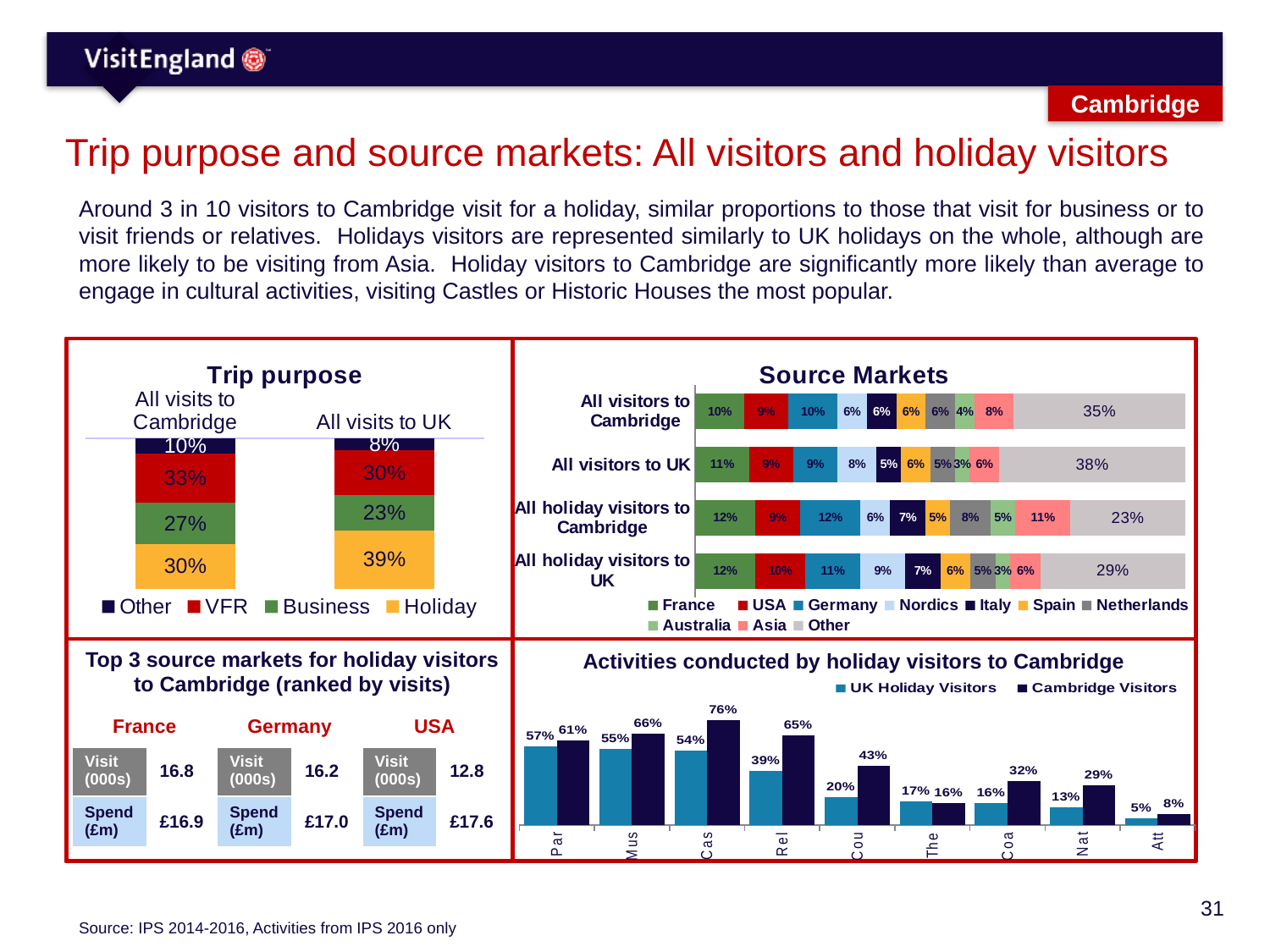
In the Activities conducted by holiday visitors to Cambridge chart, what is the difference between Cambridge Visitors and UK Holiday Visitors for the category labelled Rel? 26 percentage points In the Trip purpose chart, what percentage of all visits to UK are VFR? 30% In the Activities conducted by holiday visitors to Cambridge chart, what is the value for Cambridge Visitors for the category labelled Cas? 76% In the Source Markets chart, what is the Other share for all visitors to UK? 38% In the Activities conducted by holiday visitors to Cambridge chart, which category has the highest value for Cambridge Visitors? Cas In the Trip purpose chart, what percentage of all visits to Cambridge are for Holiday? 30% How many series does the legend of the Source Markets chart list? 10 What type of chart is the Activities conducted by holiday visitors to Cambridge chart? Bar chart How many series does the legend of the Trip purpose chart list? 4 In the Trip purpose chart, what is the difference between the Business share for all visits to Cambridge and for all visits to UK? 4 percentage points In the Source Markets chart, what is the Asia share for all holiday visitors to Cambridge? 11% How many bars does the Source Markets chart have? 4